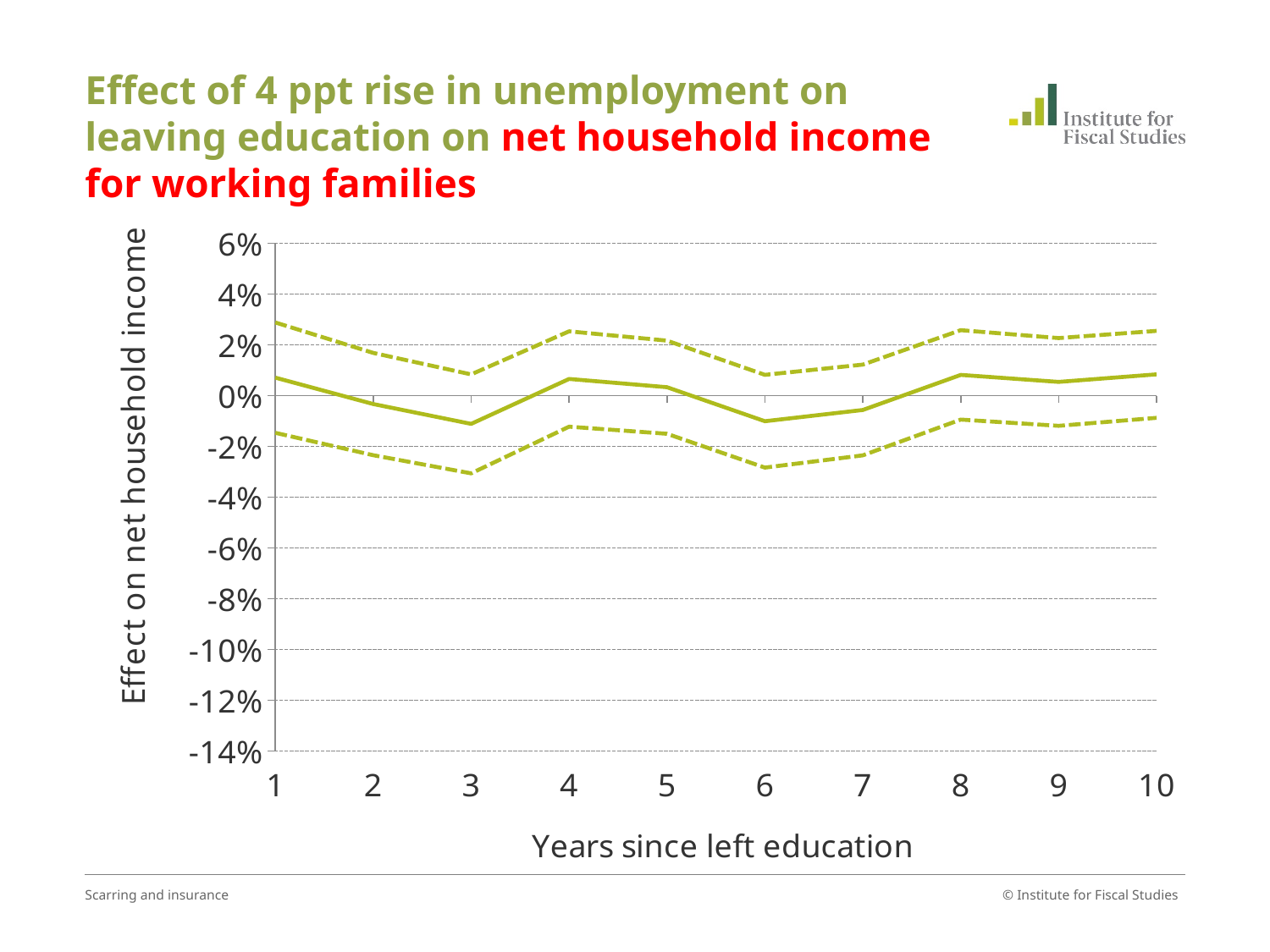
What is the label of the y axis? Effect on net household income Is the value of the upper dashed line at year 1 greater or less than 2%? greater On the solid line, is the value at year 1 or at year 3 larger? year 1 Is the value of the lower dashed line at year 8 greater or less than -2%? greater On the solid line, is the value at year 4 or at year 6 larger? year 4 What kind of chart is shown on the slide? line chart How many lines are plotted on the chart? 3 Is the value of the lower dashed line at year 3 greater or less than -2%? less What is the label of the x axis? Years since left education How many years since leaving education are shown on the x axis? 10